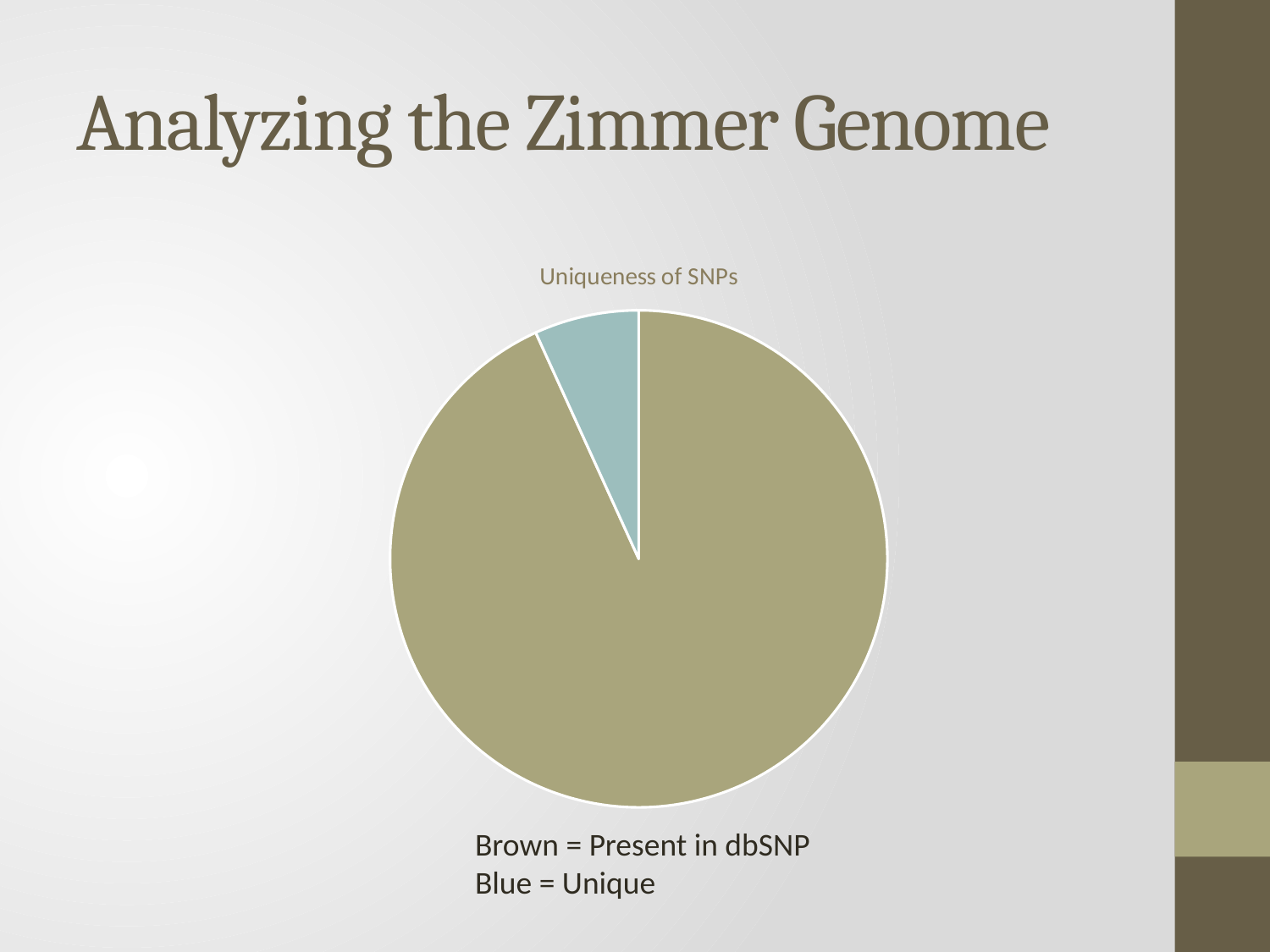
Which is larger in the pie chart: the share of SNPs present in dbSNP or the share of unique SNPs? Present in dbSNP What is the title of the pie chart? Uniqueness of SNPs Which colour represents unique SNPs in the pie chart? Blue How many slices does the pie chart have? 2 Which category takes up the smallest share of the pie chart? Unique According to the slide, what does the brown slice of the pie chart represent? Present in dbSNP Which category takes up the largest share of the pie chart? Present in dbSNP What kind of chart is shown on the slide? Pie chart